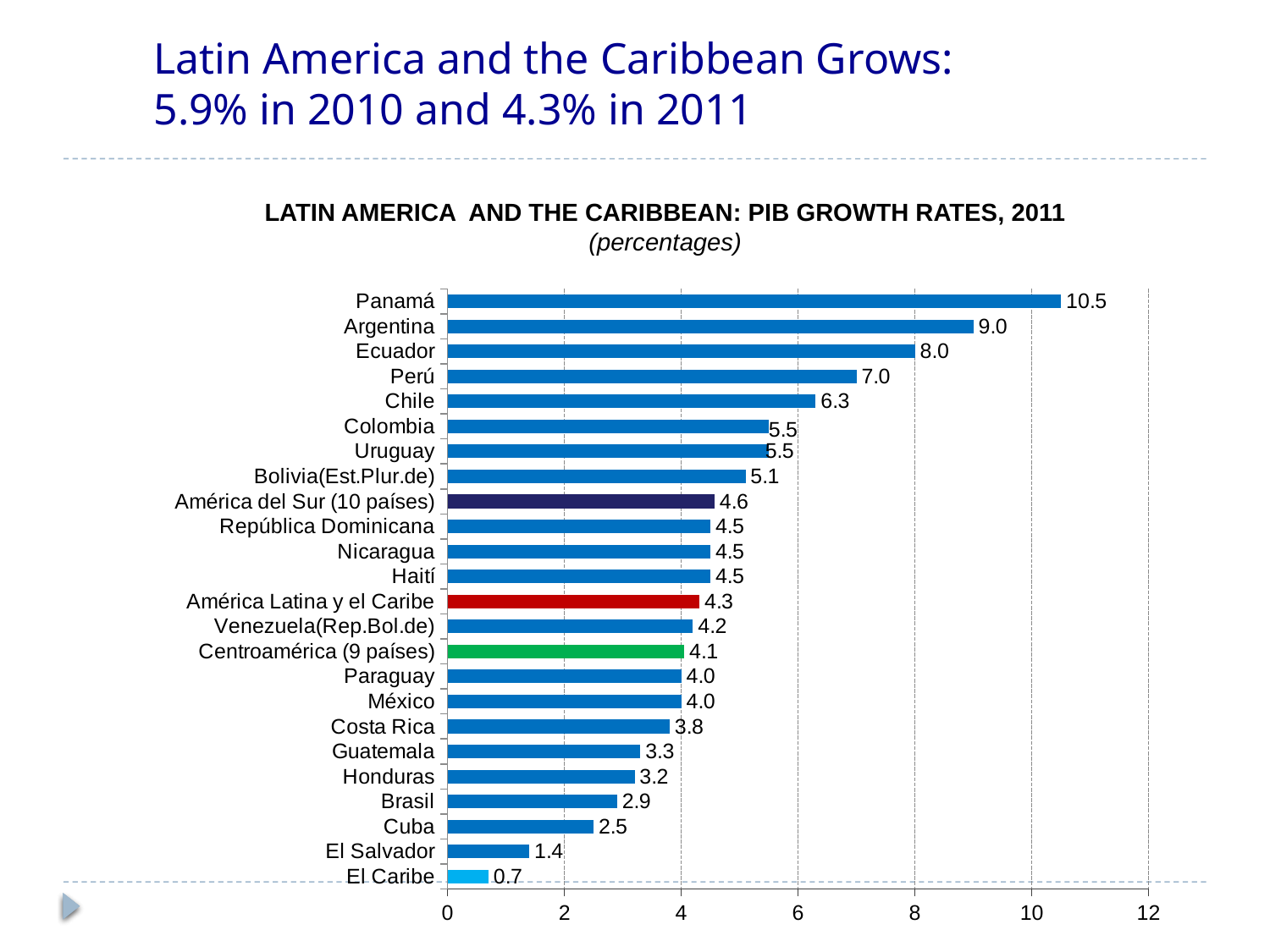
How many categories are plotted in the chart? 24 What is the PIB growth rate shown for Panamá? 10.5 What is the value shown for Centroamérica (9 países)? 4.1 What is the difference between the values for Argentina and Ecuador? 1.0 What is the title of the chart? LATIN AMERICA AND THE CARIBBEAN: PIB GROWTH RATES, 2011 What is the value shown for América Latina y el Caribe? 4.3 Which category has the highest growth rate in the chart? Panamá Which category has the lowest growth rate in the chart? El Caribe Which has a higher growth rate, Cuba or El Salvador? Cuba What kind of chart is shown on the slide? Bar chart What is the value shown for Brasil? 2.9 Which has a higher growth rate, Chile or Colombia? Chile